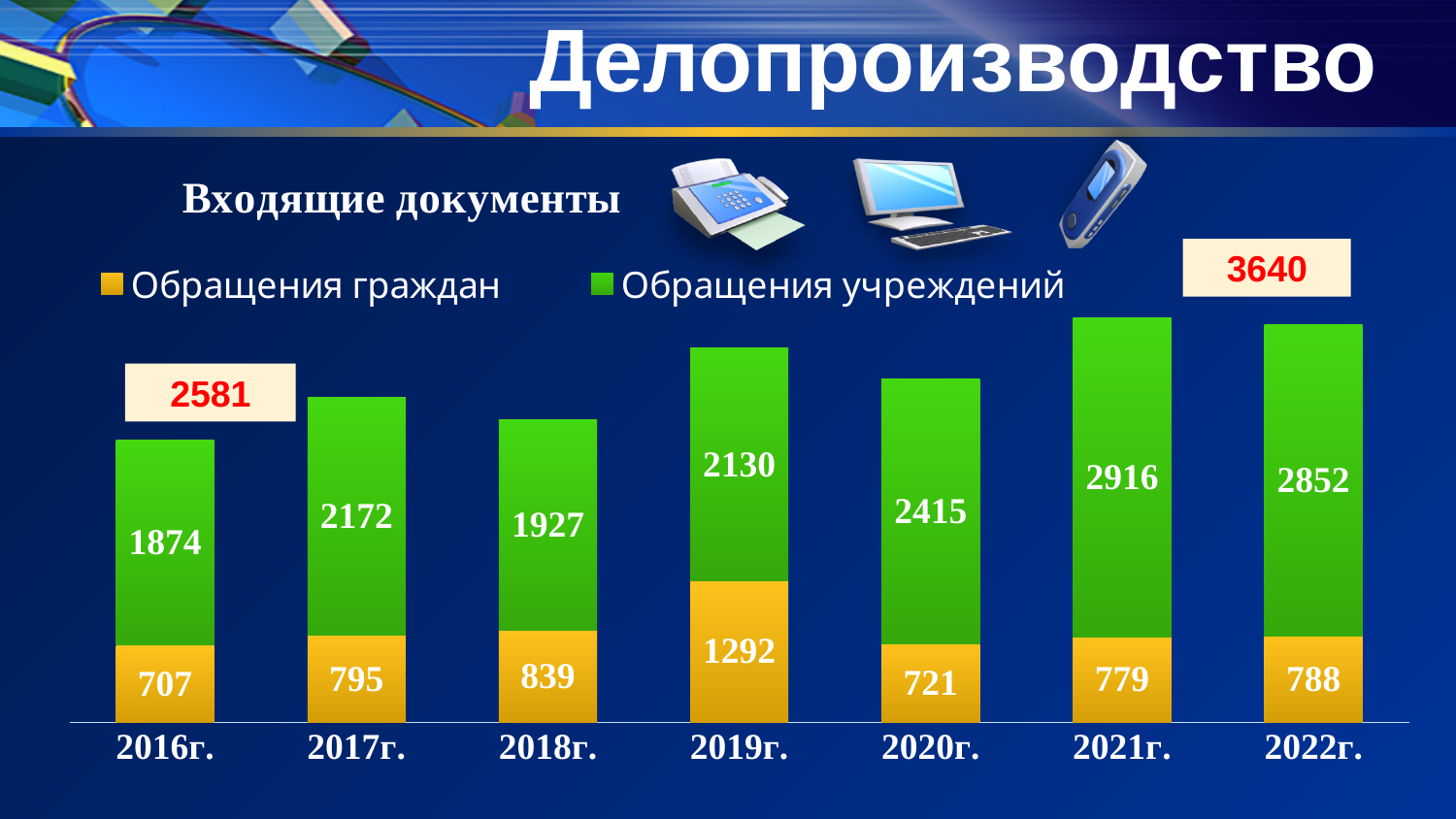
Which is larger: Обращения граждан in 2018г. or in 2020г.? 2018г. What is the total of the stacked bar for 2016г.? 2581 What is the value for Обращения граждан in 2019г.? 1292 Which colour represents Обращения граждан in the chart? orange What kind of chart is shown on the slide? stacked bar chart What is the difference between Обращения учреждений in 2021г. and 2022г.? 64 In which year is the value for Обращения граждан the lowest? 2016г. How many years are shown on the x axis of the chart? 7 What is the value for Обращения учреждений in 2020г.? 2415 In which year is the value for Обращения учреждений the highest? 2021г. What is the total of the stacked bar for 2019г.? 3422 How many series does the legend list? 2